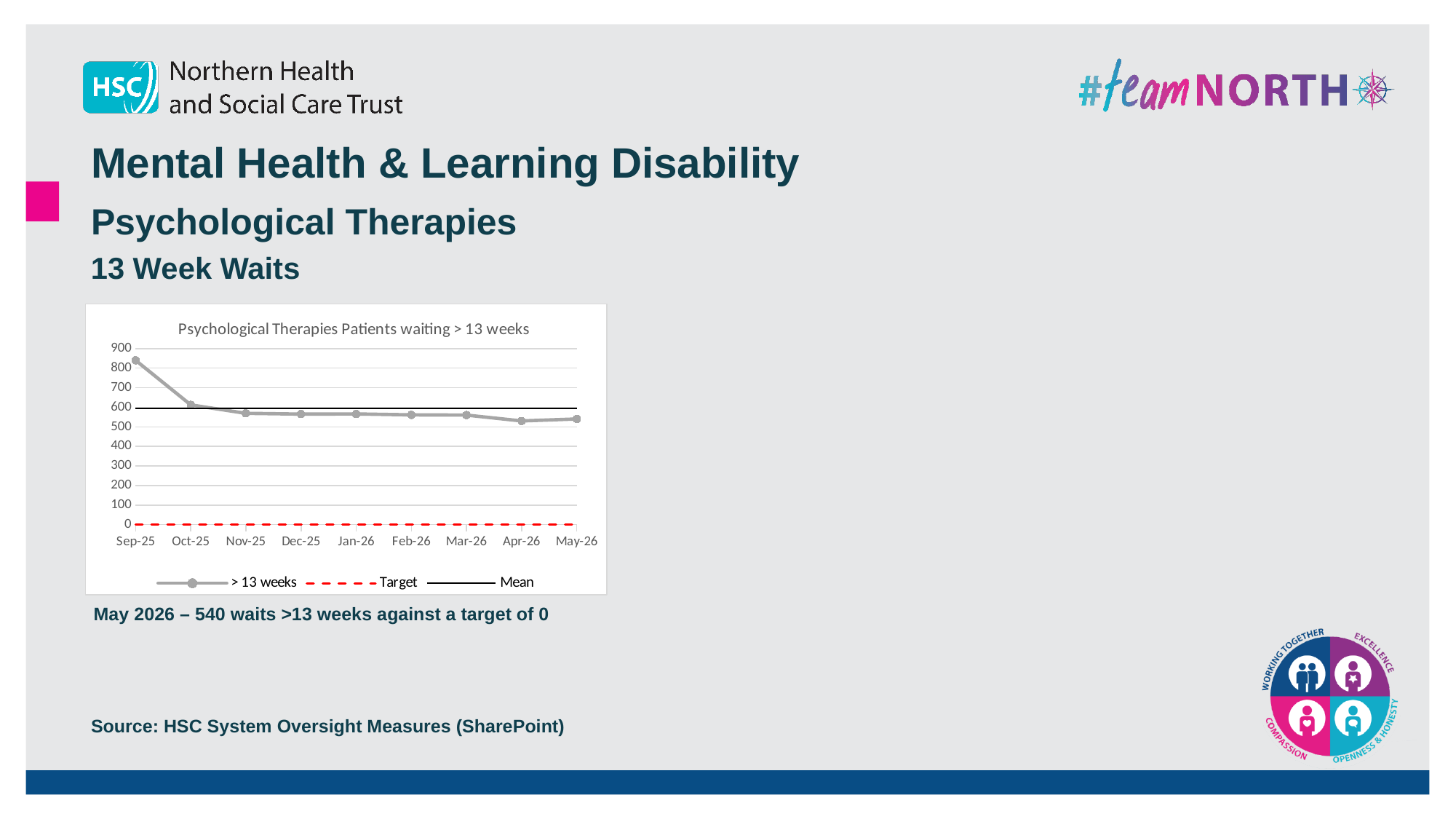
What kind of chart is shown on the slide? line chart Which month has the lowest value for the > 13 weeks series? Apr-26 How many months are plotted along the x axis of the chart? 9 What value does the Target line sit at on the chart? 0 What is the title of the chart? Psychological Therapies Patients waiting > 13 weeks Is the > 13 weeks value for Sep-25 greater or less than 800? greater Is the > 13 weeks value for Nov-25 greater or less than 600? less Which month has the highest value for the > 13 weeks series? Sep-25 What is the value of the > 13 weeks series for May-26? 540 Which is larger, the > 13 weeks value for Sep-25 or for May-26? Sep-25 Does the > 13 weeks series generally rise or fall from Sep-25 to May-26? fall How many series does the chart legend list? 3